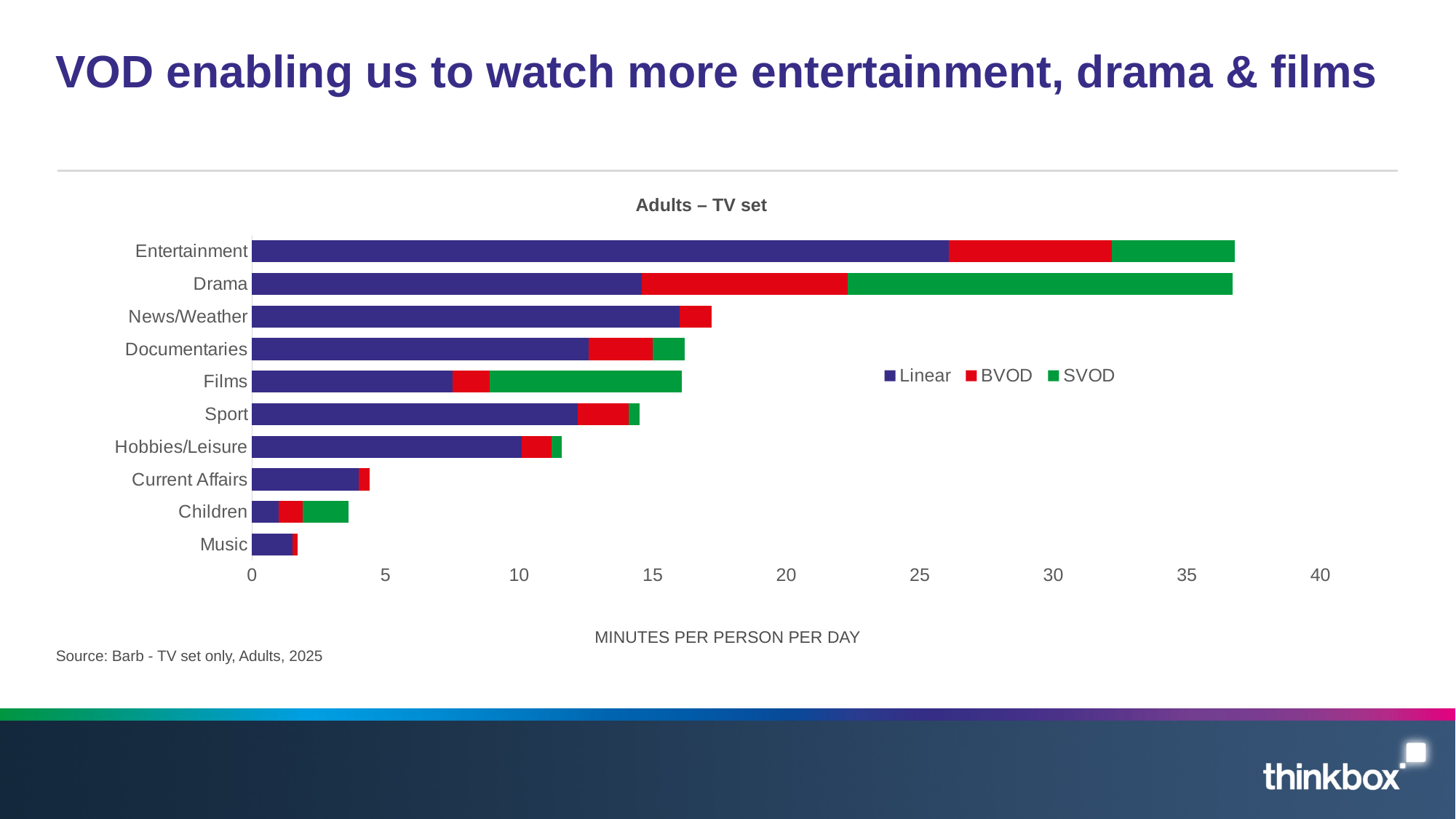
What kind of chart is shown on the slide? Stacked bar chart Is the total value for Children greater or less than 5? less Which category has the largest Linear segment? Entertainment Is the Linear value for Films greater or less than 10? less What is the title shown above the chart? Adults – TV set Which category has the largest SVOD segment? Drama Is the total value for News/Weather greater or less than 15? greater How many series does the legend list? 3 How many categories are plotted on the chart? 10 Which is larger, the SVOD segment for Films or the SVOD segment for Documentaries? Films Which category has the lowest total minutes per person per day? Music